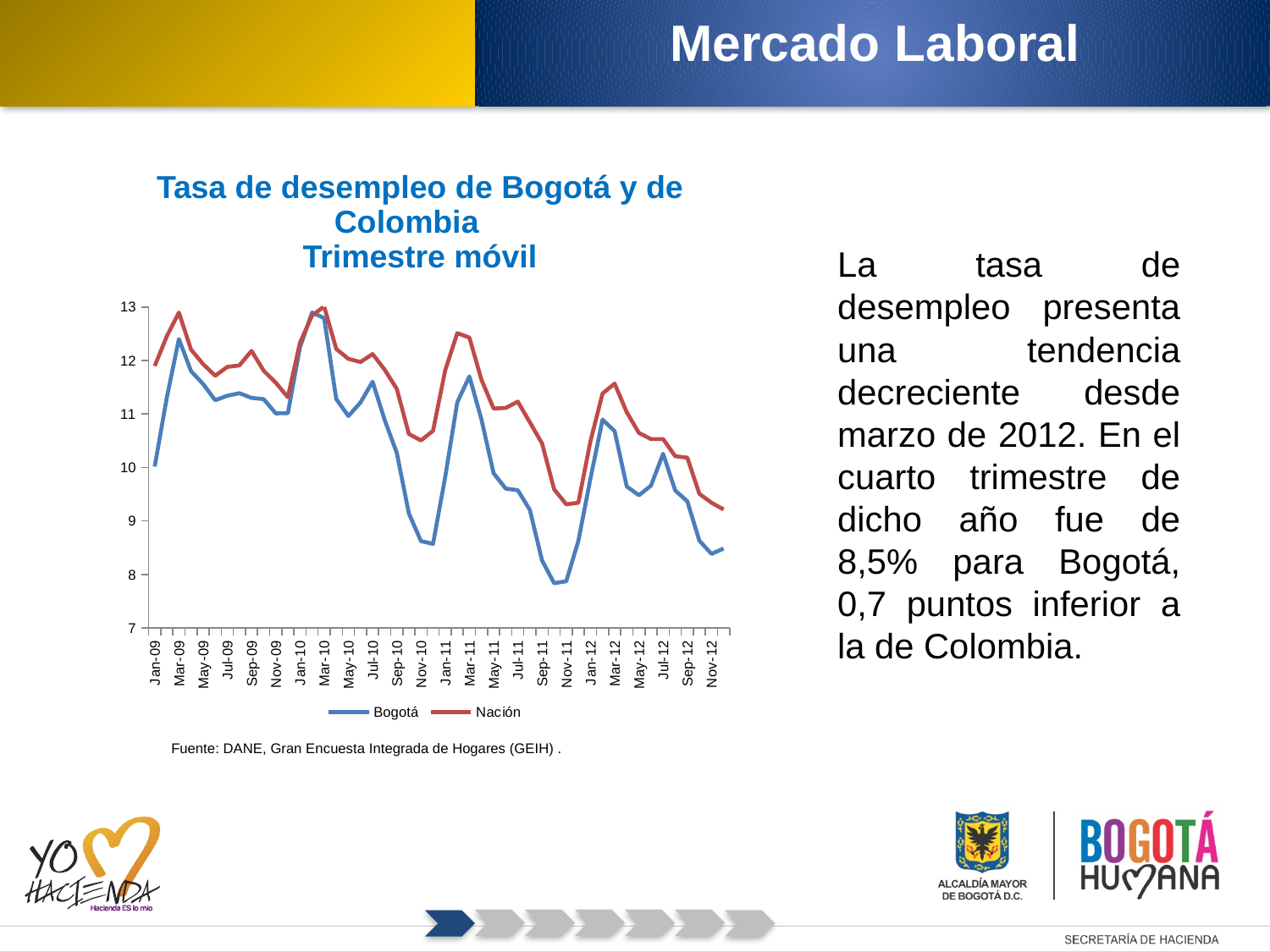
How many series does the chart legend list? 2 Is the Bogotá unemployment rate in Nov-10 greater or less than 9? less Does the Nación unemployment rate rise or fall between Mar-12 and Nov-12? Fall What kind of chart is shown on the slide? Line chart Which colour is used for the Bogotá line in the chart? Blue What are the two series named in the chart legend? Bogotá and Nación Is the Bogotá unemployment rate in Mar-09 greater or less than 12? greater Is the Bogotá unemployment rate in Nov-11 greater or less than 8? less In Nov-11, which series has the higher unemployment rate, Bogotá or Nación? Nación